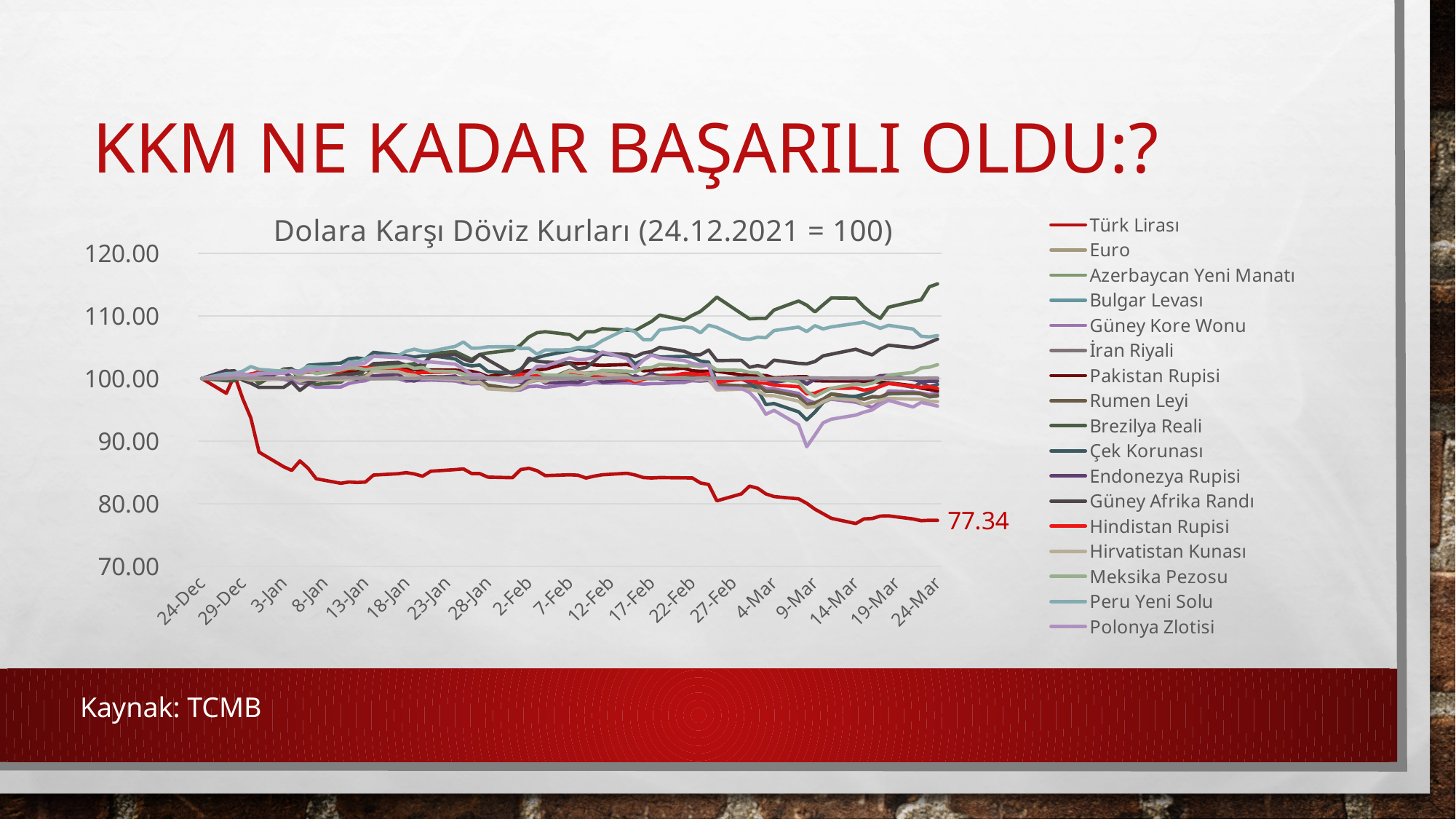
What is the title of the chart? Dolara Karşı Döviz Kurları (24.12.2021 = 100) Is the value for Brezilya Reali at 24-Mar greater or less than 110.00? greater Which series has the highest value at 24-Mar? Brezilya Reali Does the Türk Lirası line rise or fall from 24-Dec to 24-Mar? fall How many series does the legend list? 17 Which series has the lowest value at 24-Mar? Türk Lirası Which is larger at 24-Mar, Brezilya Reali or Türk Lirası? Brezilya Reali Is the value for Türk Lirası at 24-Mar greater or less than 80.00? less What is the value shown by the data label at the end of the Türk Lirası line? 77.34 How many date labels are shown on the x axis? 19 By how much did the Türk Lirası index fall from its base value of 100 to the labelled value of 77.34 at 24-Mar? 22.66 What kind of chart is shown on the slide? line chart